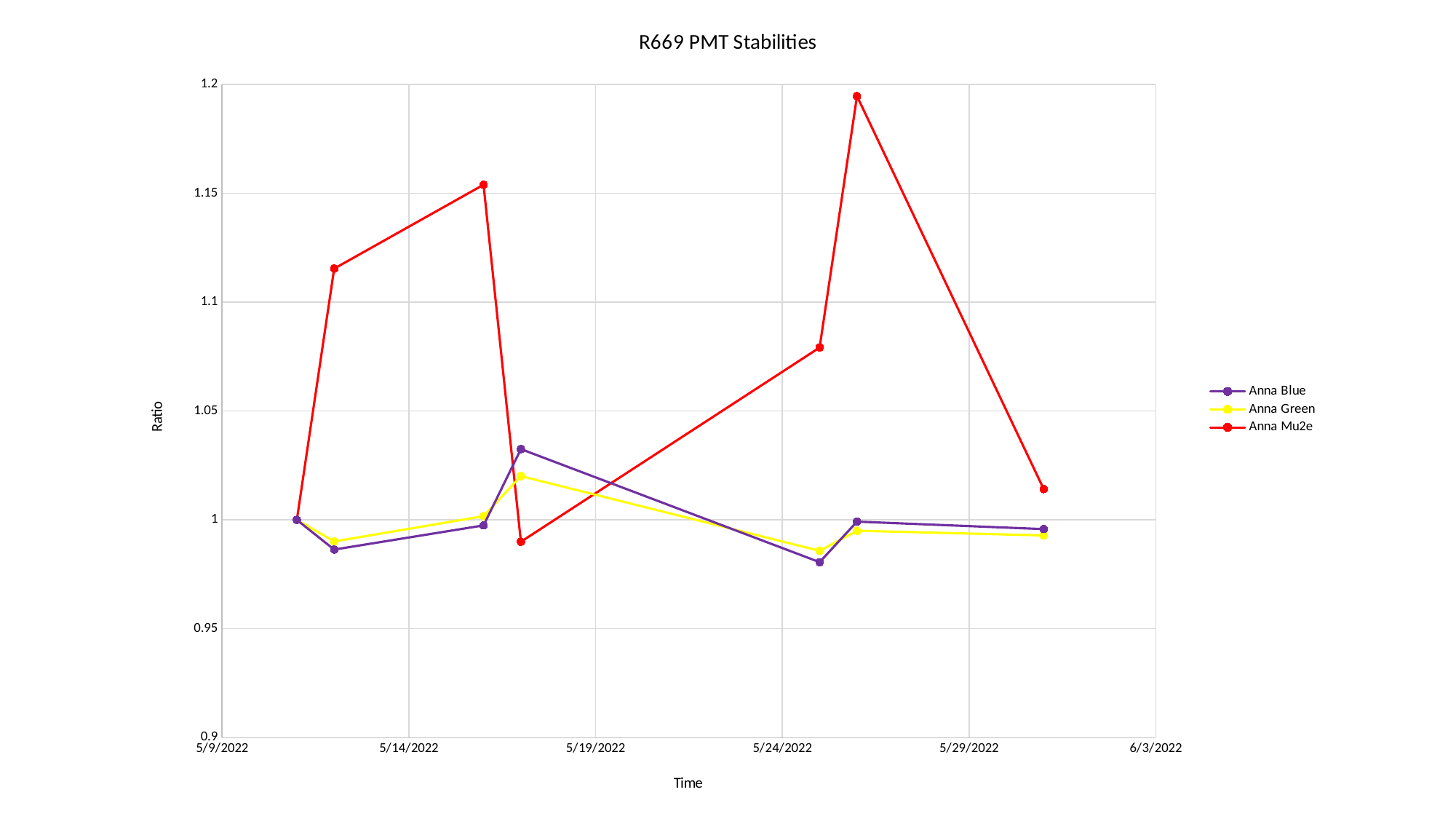
Which series reaches the highest ratio value on the chart? Anna Mu2e What is the label of the vertical axis? Ratio Is the second plotted value of the Anna Mu2e series greater or less than 1.1? greater Is the highest value of the Anna Mu2e series greater or less than 1.15? greater What is the title of the chart? R669 PMT Stabilities At their first data point, what ratio value do all three series share? 1 How many data points are plotted for the Anna Mu2e series? 7 Is the lowest value of the Anna Blue series greater or less than 1? less What type of chart is shown on the slide? line chart How many series does the legend list? 3 At the peak just before 5/19/2022, which series is higher: Anna Blue or Anna Green? Anna Blue